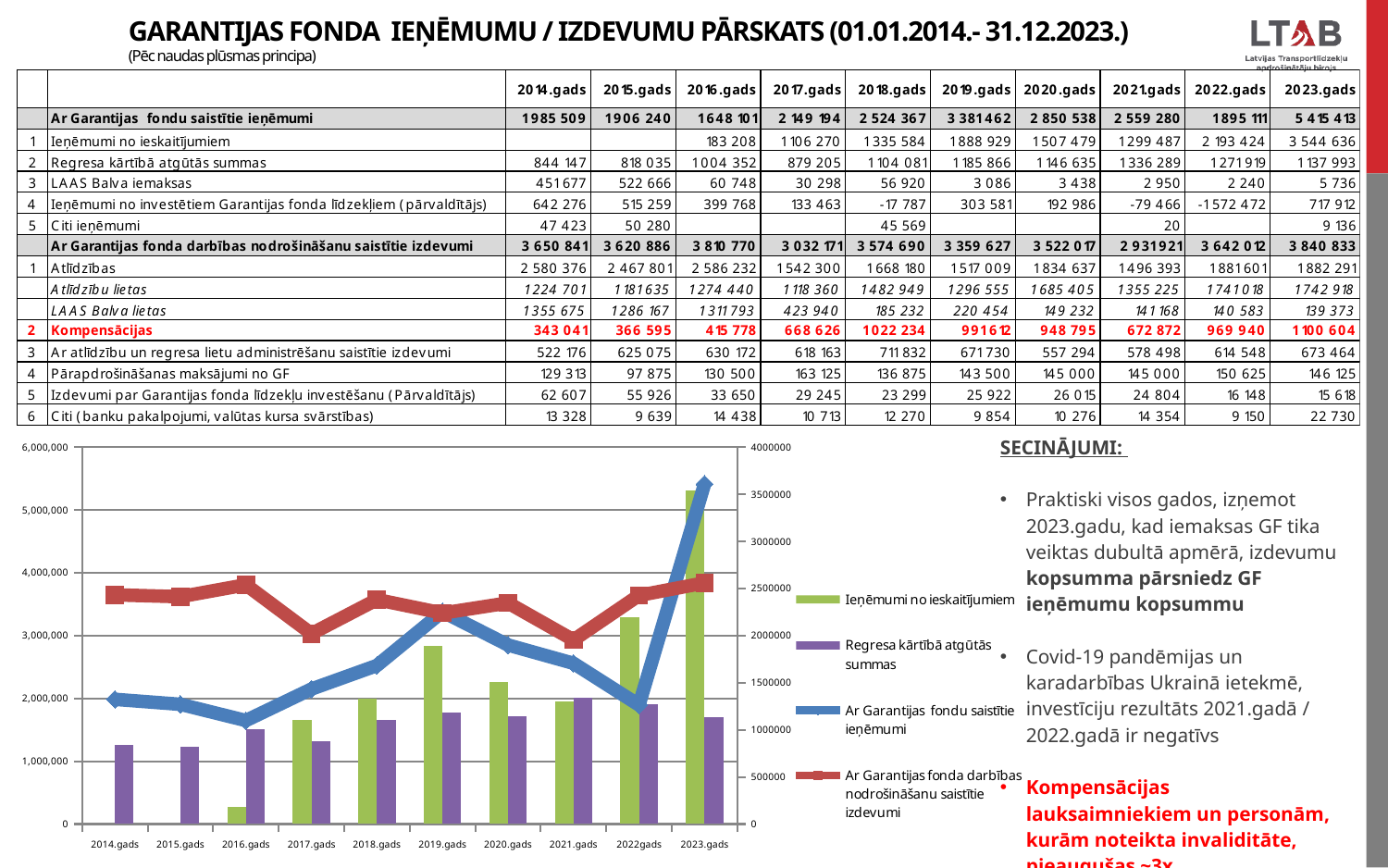
In 2023.gads, which is higher: the blue line 'Ar Garantijas fondu saistītie ieņēmumi' or the red line 'Ar Garantijas fonda darbības nodrošināšanu saistītie izdevumi'? The blue line (Ar Garantijas fondu saistītie ieņēmumi) How many years (categories) are shown along the x axis of the chart? 10 Does the blue line 'Ar Garantijas fondu saistītie ieņēmumi' rise or fall from 2016.gads to 2018.gads? rise How many series does the chart legend list? 4 In which year does the blue line 'Ar Garantijas fondu saistītie ieņēmumi' reach its highest point? 2023.gads In which year is the blue line 'Ar Garantijas fondu saistītie ieņēmumi' at its lowest point? 2016.gads What colour represents 'Regresa kārtībā atgūtās summas' in the chart legend? Purple Is the green bar 'Ieņēmumi no ieskaitījumiem' for 2016.gads greater or less than 500,000? less What kind of chart is shown at the bottom left of the slide? A combined bar and line chart Is the value of the blue line 'Ar Garantijas fondu saistītie ieņēmumi' for 2023.gads greater or less than 5,000,000 on the left axis? greater In which year is the green bar 'Ieņēmumi no ieskaitījumiem' the tallest? 2023.gads Is the value of the red line 'Ar Garantijas fonda darbības nodrošināšanu saistītie izdevumi' for 2014.gads greater or less than 3,000,000 on the left axis? greater